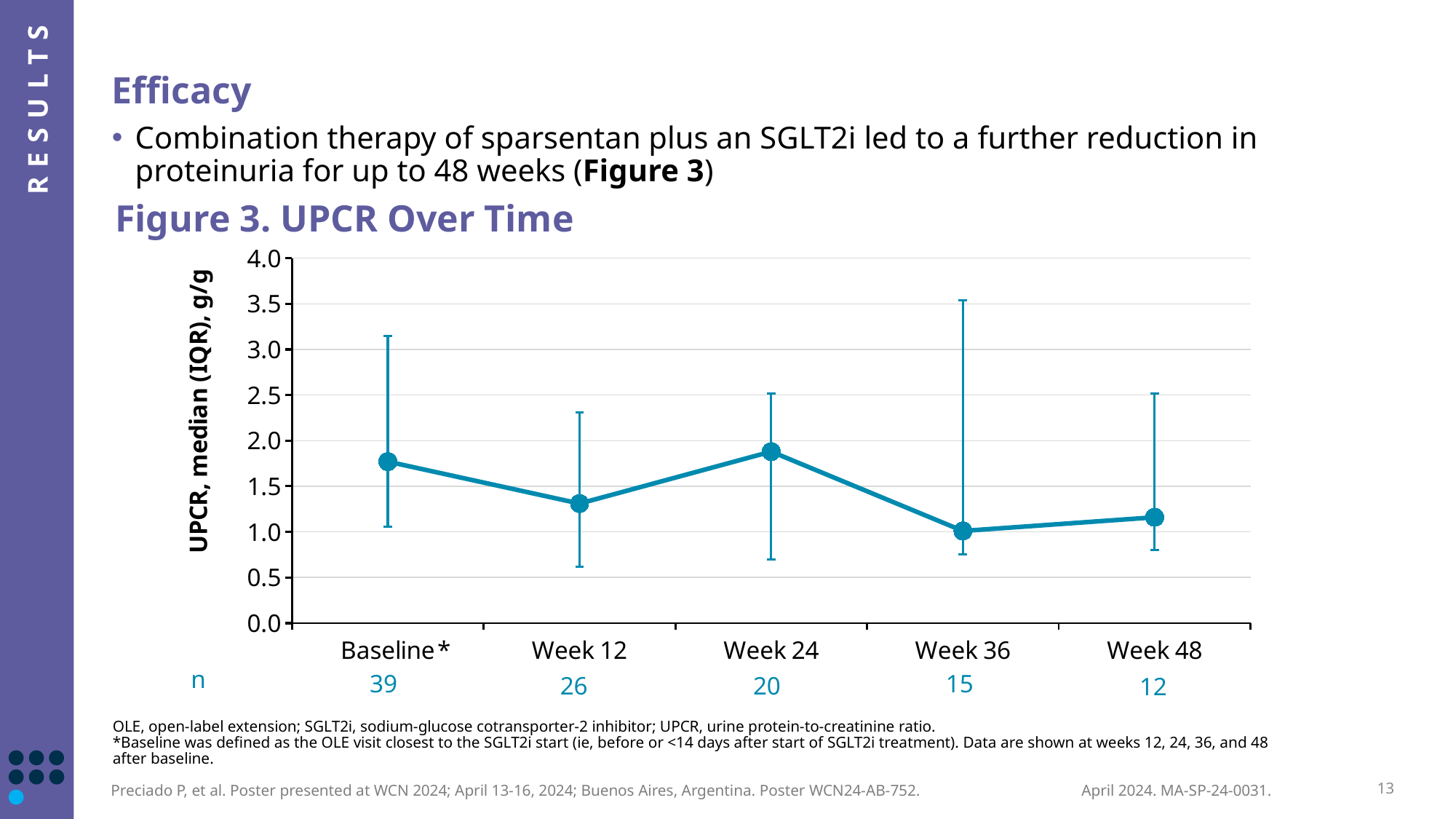
Is the median UPCR at Week 36 greater or less than 1.5 g/g? less What is the n value shown for Week 24 in the UPCR Over Time chart? 20 Which has a higher median UPCR, Baseline or Week 36? Baseline By how much does the n value at Baseline exceed the n value at Week 48? 27 Which has a higher median UPCR, Week 12 or Week 24? Week 24 Is the median UPCR at Baseline greater or less than 1.5 g/g? greater What kind of chart is shown in Figure 3? line chart What is the label of the y axis in the UPCR Over Time chart? UPCR, median (IQR), g/g What is the n value shown for Baseline in the UPCR Over Time chart? 39 What is the n value shown for Week 48 in the UPCR Over Time chart? 12 How many time points are plotted on the x axis of the UPCR Over Time chart? 5 Is the median UPCR at Week 24 greater or less than 1.5 g/g? greater